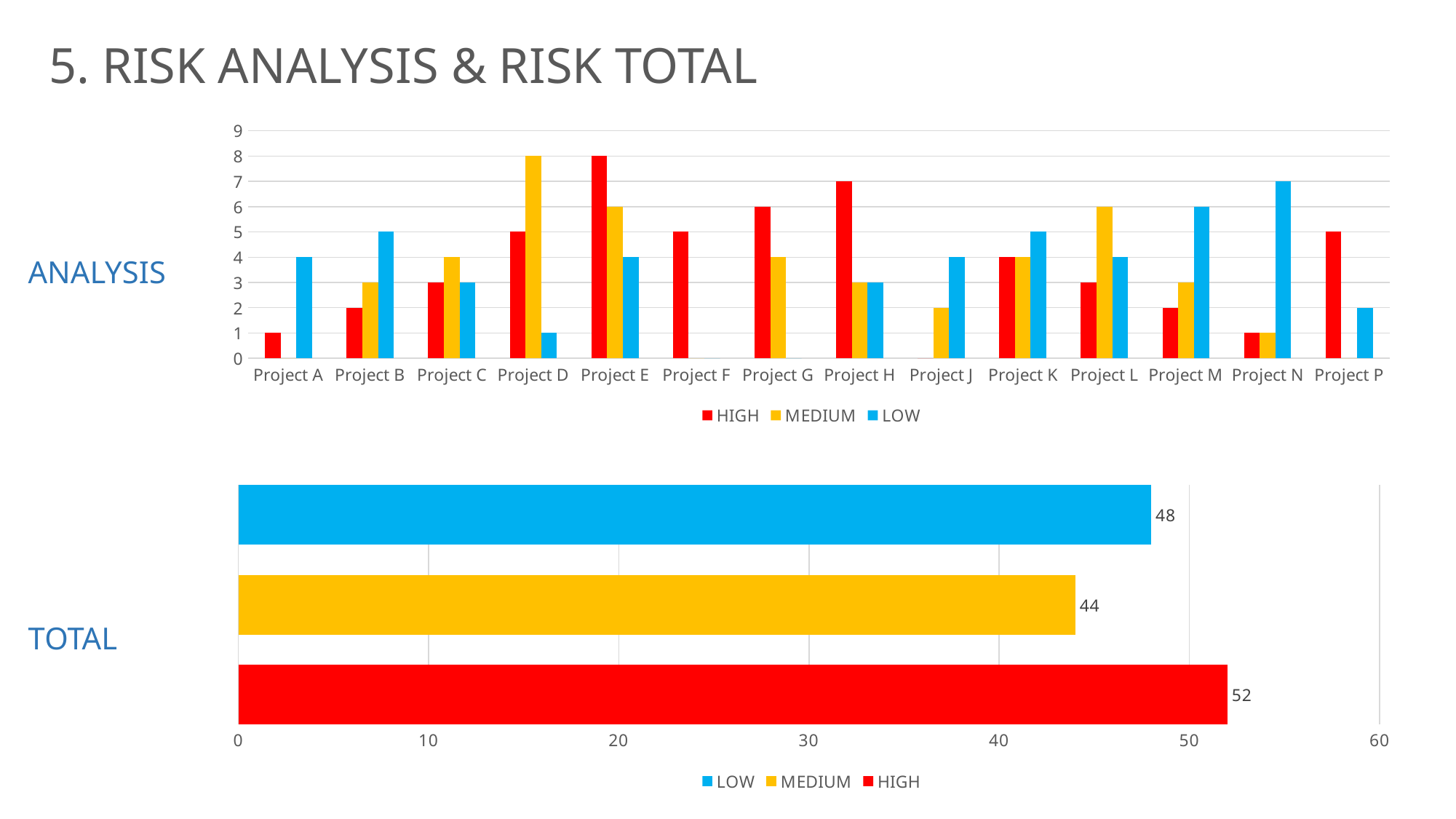
In the ANALYSIS chart, what is the HIGH value for Project E? 8 In the ANALYSIS chart, what is the LOW value for Project N? 7 In the ANALYSIS chart, is the LOW value for Project B larger than the LOW value for Project A? Yes In the ANALYSIS chart, which project has the highest HIGH value? Project E In the TOTAL chart, what is the value for MEDIUM? 44 In the ANALYSIS chart, what is the MEDIUM value for Project D? 8 How many series does the legend of the ANALYSIS chart list? 3 In the TOTAL chart, which category has the lowest value? MEDIUM In the TOTAL chart, what is the value for HIGH? 52 In the TOTAL chart, is the value for LOW greater or less than 50? less How many projects are shown on the x axis of the ANALYSIS chart? 14 In the TOTAL chart, what is the difference between the HIGH and LOW values? 4